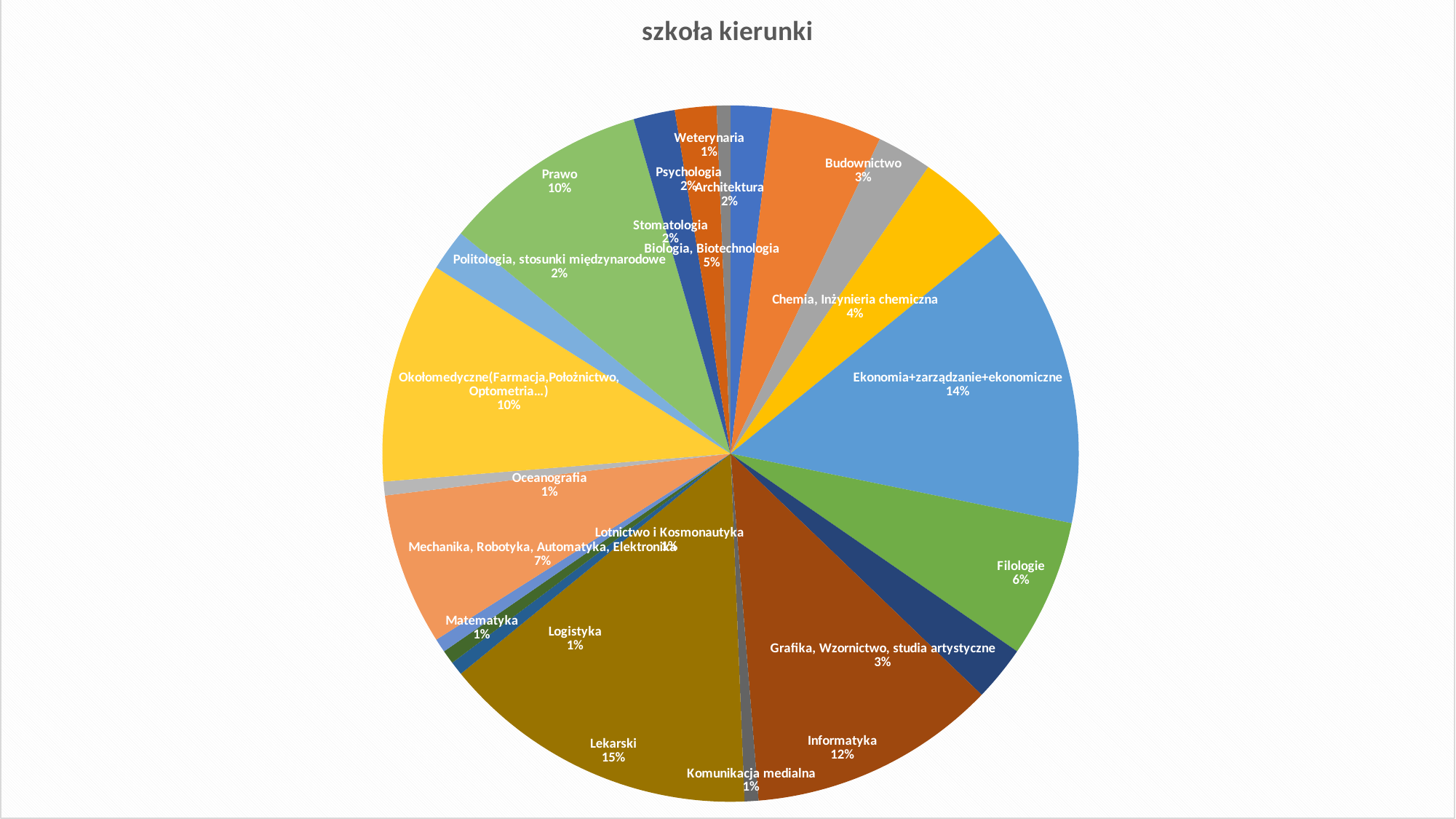
What is the title of the chart? szkoła kierunki What is the value shown for Prawo? 10% What share of the pie does Lekarski have? 15% What is the value shown for Chemia, Inżynieria chemiczna? 4% What is the difference between the shares of Informatyka and Biologia, Biotechnologia? 7% What is the value shown for Weterynaria? 1% Which is larger, Filologie or Budownictwo? Filologie What is the value shown for Informatyka? 12% What share of the pie does Ekonomia+zarządzanie+ekonomiczne have? 14% What kind of chart is shown on the slide? pie chart Which category has the largest share of the pie? Lekarski What is the value shown for Mechanika, Robotyka, Automatyka, Elektronika? 7%